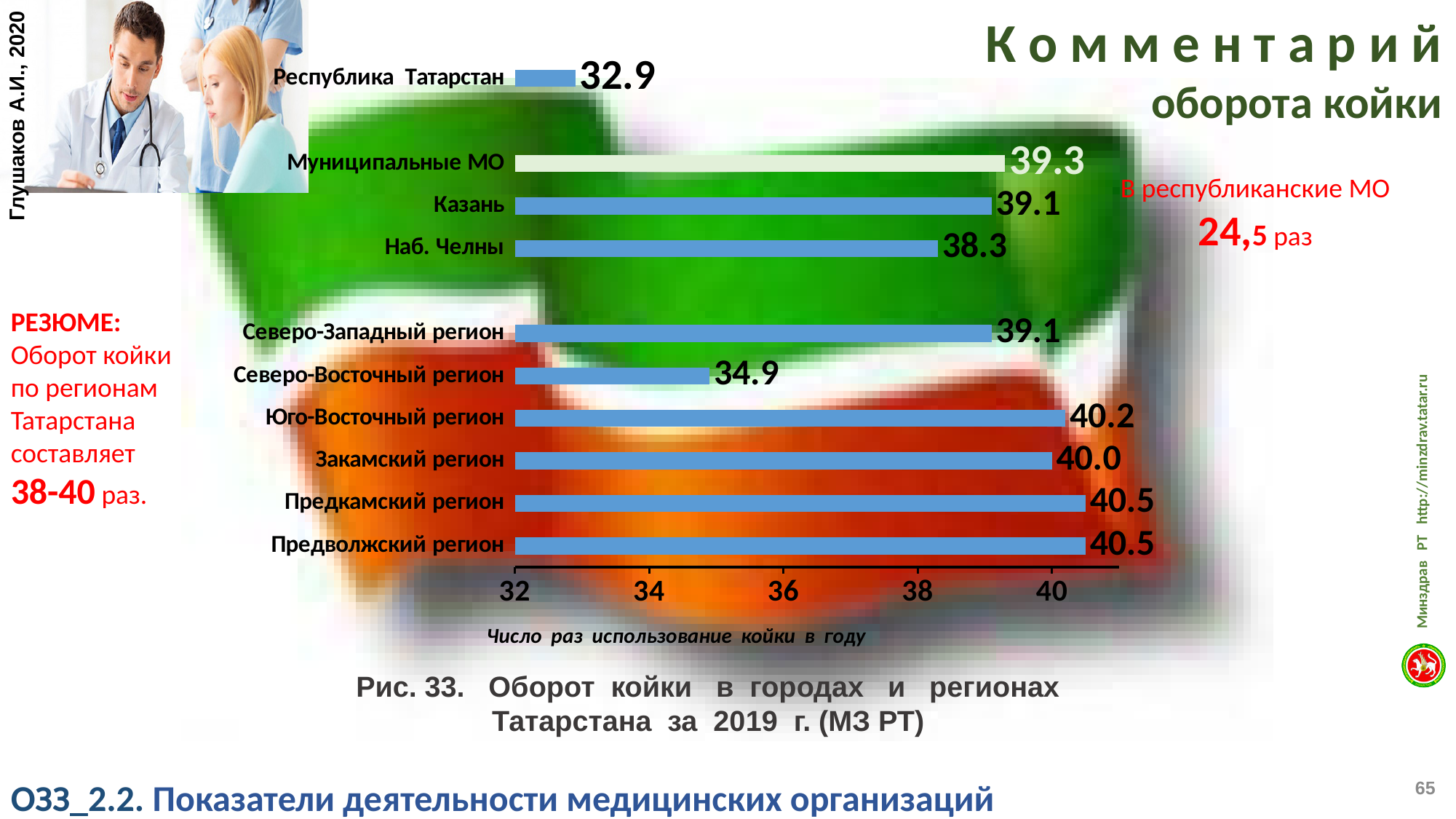
What is the value for Северо-Восточный регион? 34.9 What is the value for Казань? 39.1 What is the figure number given in the chart caption? Рис. 33 Is the value for Северо-Западный регион greater or less than 38? greater How many categories are shown in the chart? 10 What is the difference between the values for Юго-Восточный регион and Северо-Восточный регион? 5.3 What is the value for Наб. Челны? 38.3 What is the label of the horizontal axis? Число раз использование койки в году Which category has the lowest value? Республика Татарстан What kind of chart is shown on the slide? bar chart What is the value for Муниципальные МО? 39.3 Which is larger, the value for Закамский регион or the value for Наб. Челны? Закамский регион